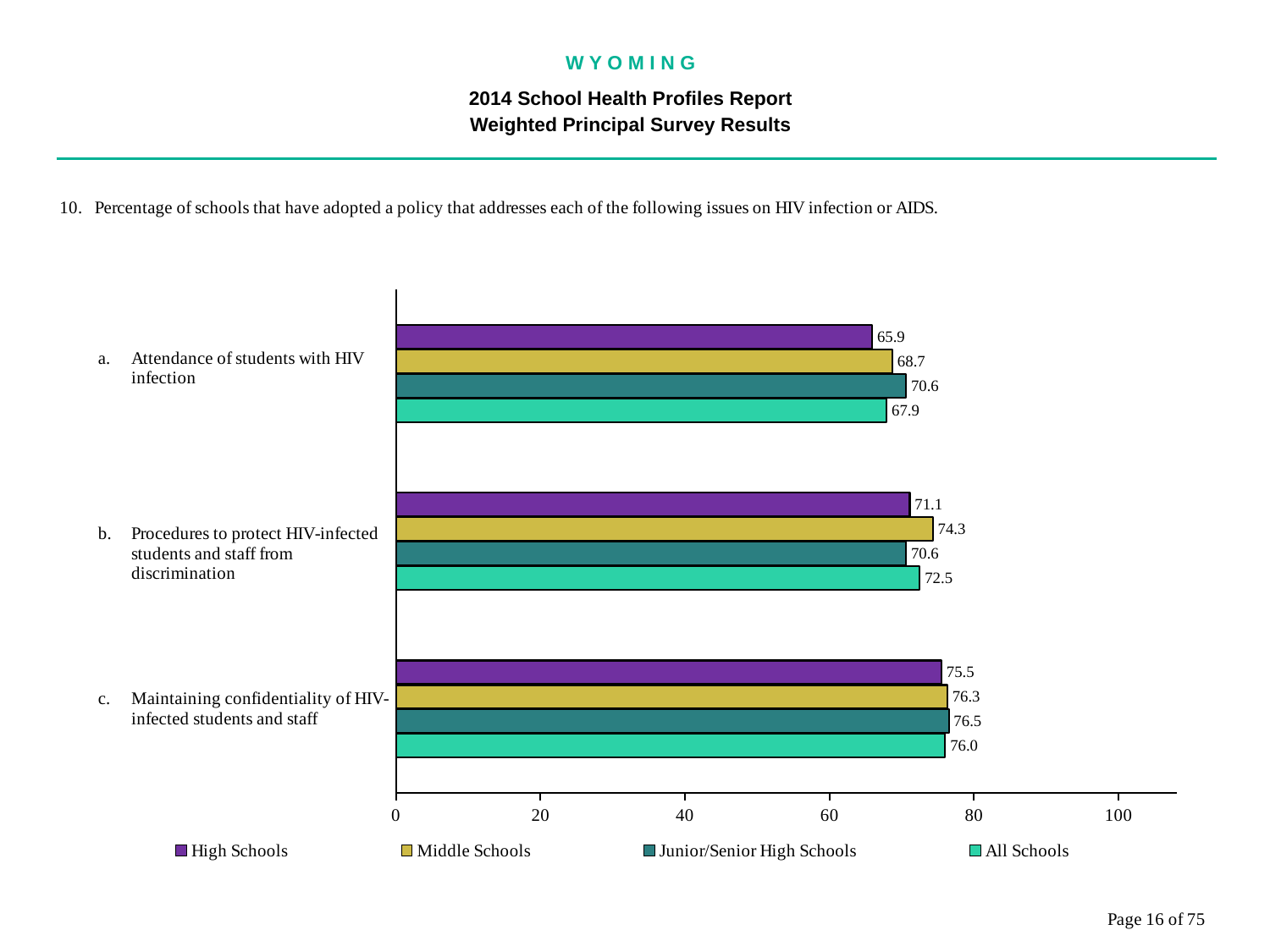
What is the value for High Schools for 'Attendance of students with HIV infection'? 65.9 What is the value for Junior/Senior High Schools for 'Attendance of students with HIV infection'? 70.6 How many series does the legend list? 4 How many categories are shown on the chart? 3 What is the value for Middle Schools for 'Procedures to protect HIV-infected students and staff from discrimination'? 74.3 For 'Procedures to protect HIV-infected students and staff from discrimination', which is larger: the Middle Schools value or the Junior/Senior High Schools value? Middle Schools Which series is shown in purple in the legend? High Schools What kind of chart is shown on the slide? Bar chart What is the difference between the Middle Schools and High Schools values for 'Attendance of students with HIV infection'? 2.8 What is the value for All Schools for 'Maintaining confidentiality of HIV-infected students and staff'? 76.0 Which category has the highest value for High Schools? Maintaining confidentiality of HIV-infected students and staff Which category has the lowest value for All Schools? Attendance of students with HIV infection